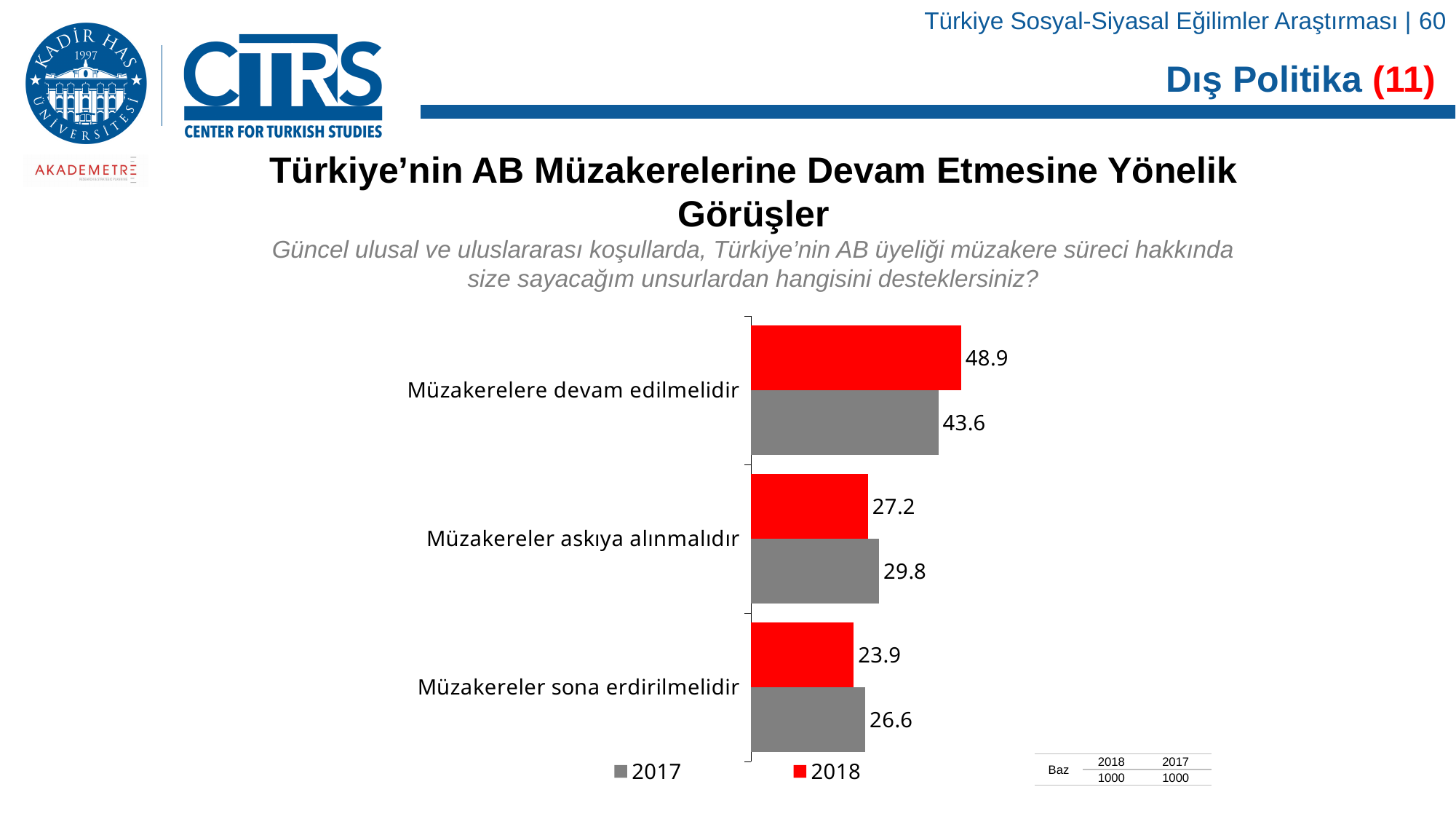
What is the 2018 value for "Müzakerelere devam edilmelidir"? 48.9 What is the difference between the 2017 and 2018 values for "Müzakereler askıya alınmalıdır"? 2.6 For "Müzakereler sona erdirilmelidir", which year has the larger value, 2017 or 2018? 2017 What kind of chart is shown on the slide? Bar chart What is the 2017 value for "Müzakereler sona erdirilmelidir"? 26.6 How many categories are shown in the chart? 3 What is the 2018 value for "Müzakereler sona erdirilmelidir"? 23.9 What is the 2017 value for "Müzakereler askıya alınmalıdır"? 29.8 What is the difference between the 2018 and 2017 values for "Müzakerelere devam edilmelidir"? 5.3 Which category has the highest 2018 value? Müzakerelere devam edilmelidir Which category has the lowest 2017 value? Müzakereler sona erdirilmelidir How many series does the legend list? 2